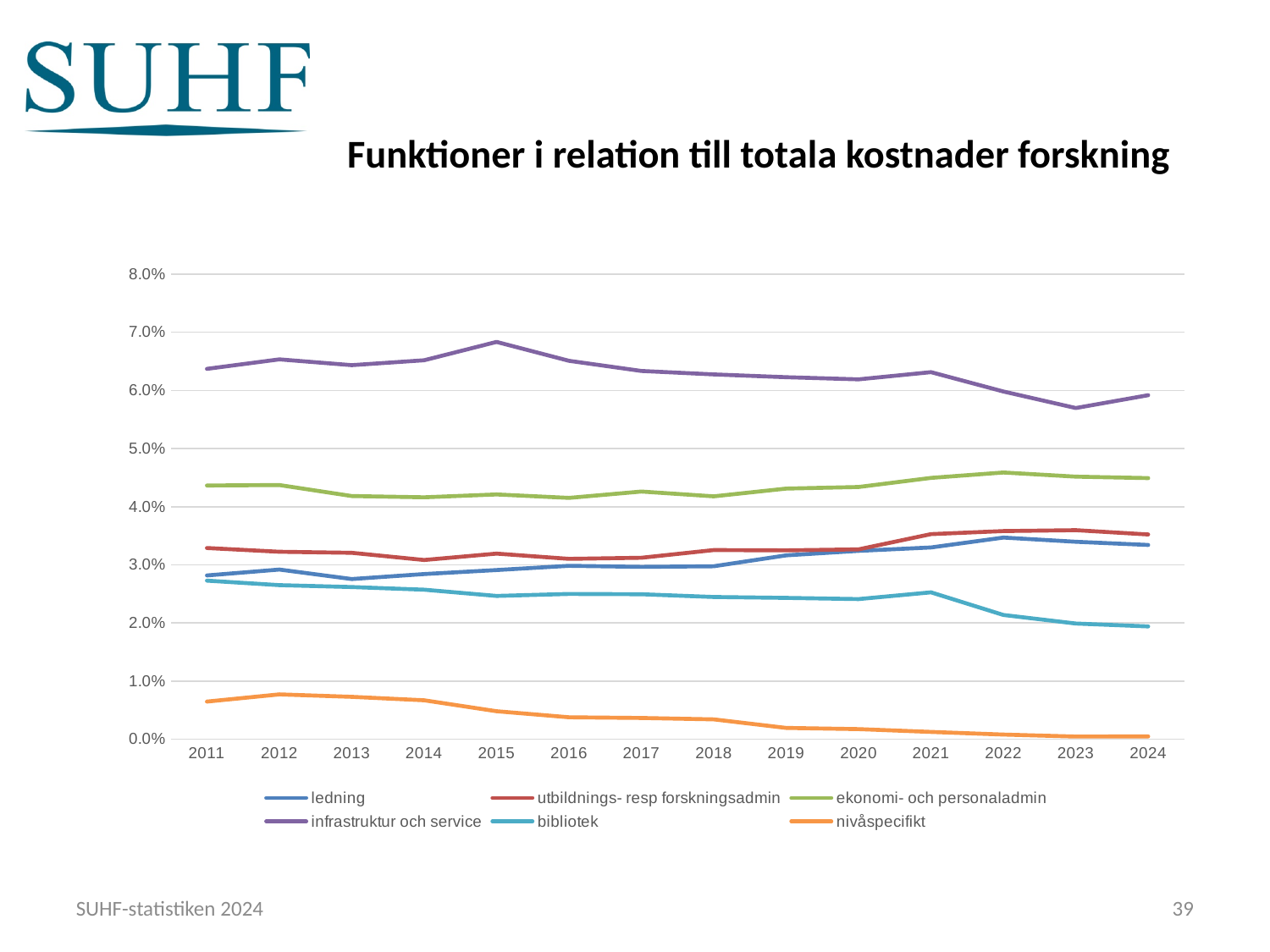
In 2024, which is larger: ekonomi- och personaladmin or ledning? ekonomi- och personaladmin Which series has the highest values across all years? infrastruktur och service Which series has the lowest values across all years? nivåspecifikt What kind of chart is shown on the slide? line chart How many series does the legend list? 6 How many years are shown on the x axis? 14 What is the title of the chart? Funktioner i relation till totala kostnader forskning Is the value for nivåspecifikt in 2012 greater or less than 1.0%? less Does the nivåspecifikt series rise or fall from 2011 to 2024? fall Is the value for ekonomi- och personaladmin in 2022 greater or less than 4.0%? greater Is the value for infrastruktur och service in 2015 greater or less than 6.0%? greater In which year does the infrastruktur och service series reach its highest value? 2015